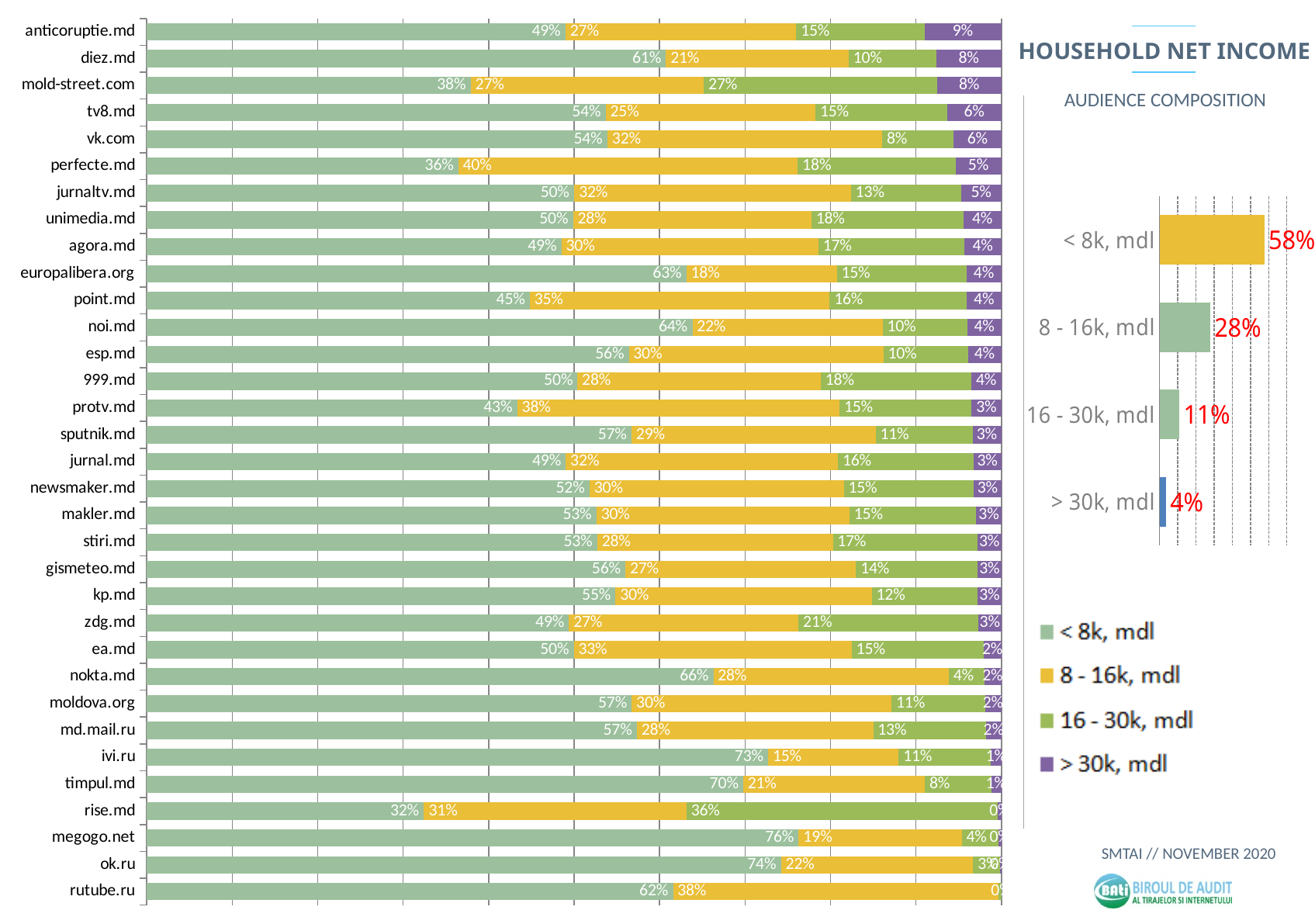
How many websites are listed in the stacked bar chart on the left? 33 What type of chart is the large chart on the left of the slide? Stacked bar chart How many income groups does the legend of the stacked bar chart list? 4 In the stacked bar chart on the left, what share of rise.md's audience is in the 16 - 30k, mdl income group? 36% In the stacked bar chart on the left, what share of megogo.net's audience is in the < 8k, mdl income group? 76% In the stacked bar chart on the left, what share of anticoruptie.md's audience is in the > 30k, mdl income group? 9% In the Household Net Income chart on the right, which income group has the largest share of the audience? < 8k, mdl In the stacked bar chart on the left, which has a larger share of audience in the < 8k, mdl group: ivi.ru or megogo.net? megogo.net In the Household Net Income chart on the right, what is the difference in percentage points between the < 8k, mdl group and the 8 - 16k, mdl group? 30 percentage points In the stacked bar chart on the left, which website has the highest share of audience in the > 30k, mdl income group? anticoruptie.md In the Household Net Income chart on the right, what percentage of the audience is in the < 8k, mdl income group? 58% In the Household Net Income chart on the right, which income group has the smallest share of the audience? > 30k, mdl